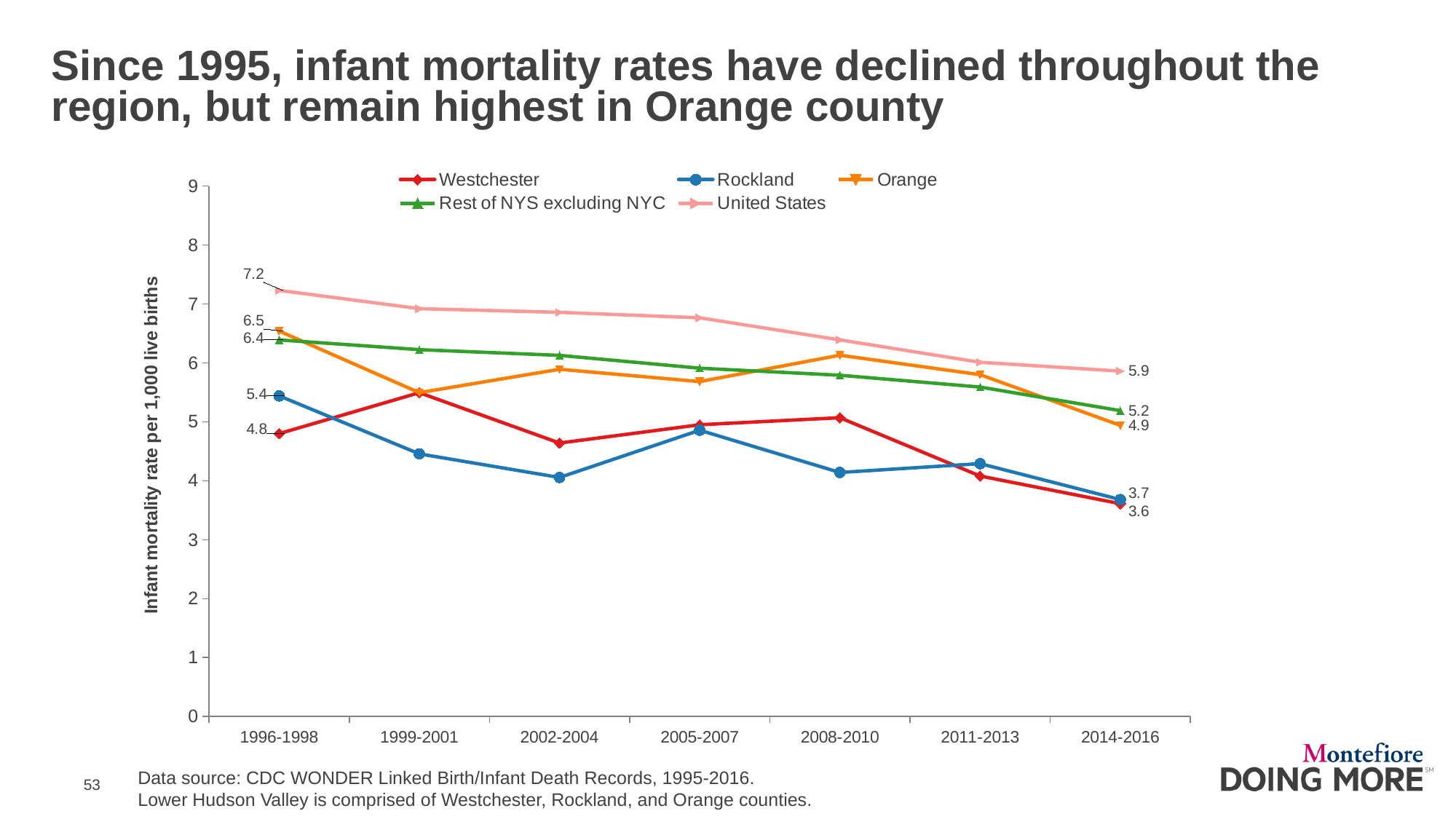
How many series does the legend list? 5 Does the United States line rise or fall from 1996-1998 to 2014-2016? fall What was the infant mortality rate for Rockland in 2014-2016? 3.7 How many time periods are shown on the x axis? 7 What type of chart is shown on the slide? line chart Is the value for Rest of NYS excluding NYC in 2008-2010 greater or less than 6? less Which series had the highest infant mortality rate in 2014-2016? United States What was the infant mortality rate for the United States in 1996-1998? 7.2 By how much did the United States infant mortality rate fall from 1996-1998 to 2014-2016? 1.3 What was the infant mortality rate for Orange in 2014-2016? 4.9 What was the infant mortality rate for Westchester in 1996-1998? 4.8 Which series had the lowest infant mortality rate in 1996-1998? Westchester